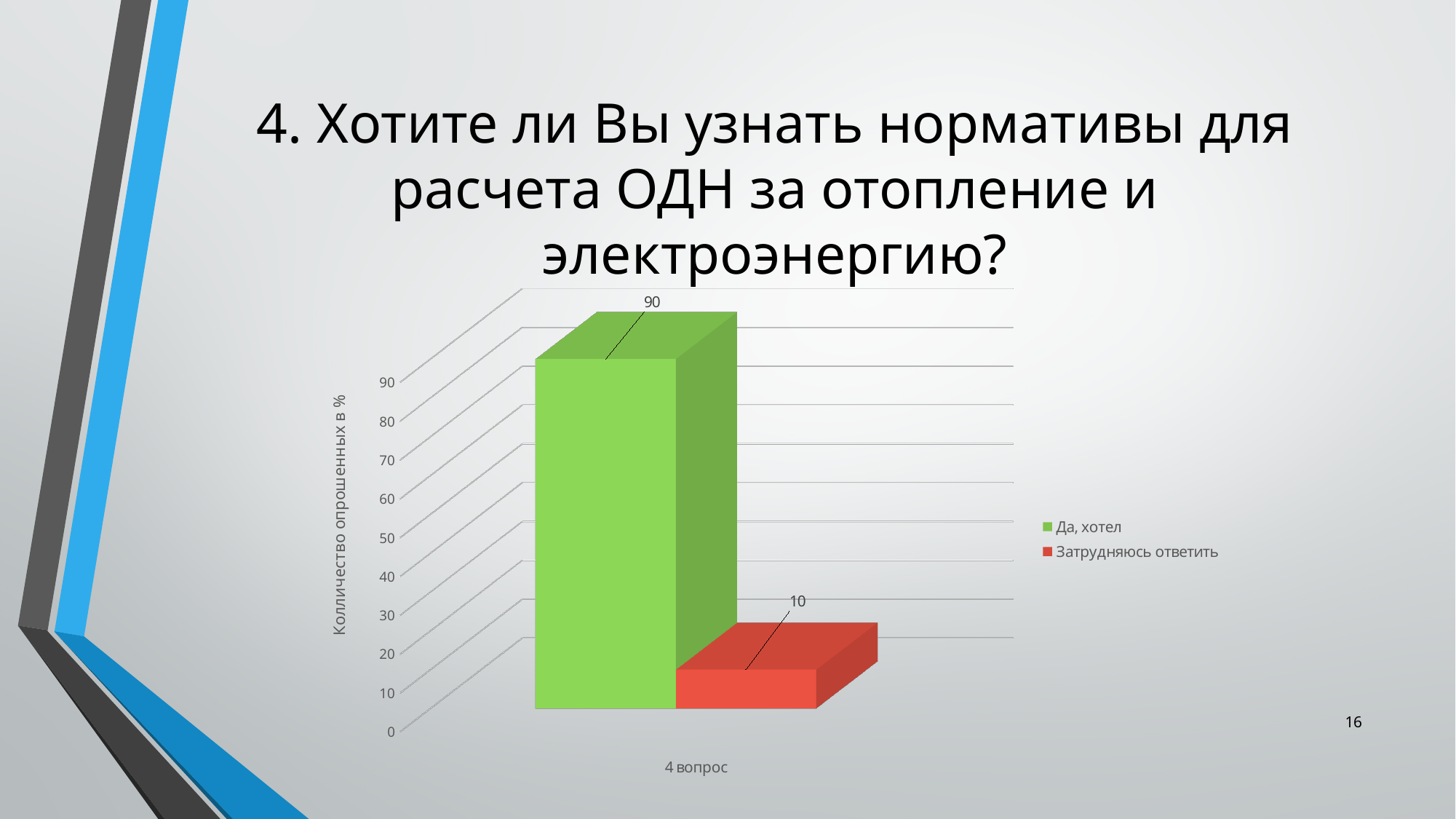
What is the difference between the values for "Да, хотел" and "Затрудняюсь ответить"? 80 How many series does the legend list? 2 Which series has the highest value? Да, хотел Which is larger, the value for "Да, хотел" or for "Затрудняюсь ответить"? Да, хотел What is the value for "Да, хотел"? 90 What is the category label shown on the horizontal axis? 4 вопрос Which series has the lowest value? Затрудняюсь ответить Is the value for "Да, хотел" greater or less than 50? greater What kind of chart is shown on the slide? bar chart What is the label on the vertical axis of the chart? Колличество опрошенных в % Is the value for "Затрудняюсь ответить" greater or less than 20? less What is the value for "Затрудняюсь ответить"? 10